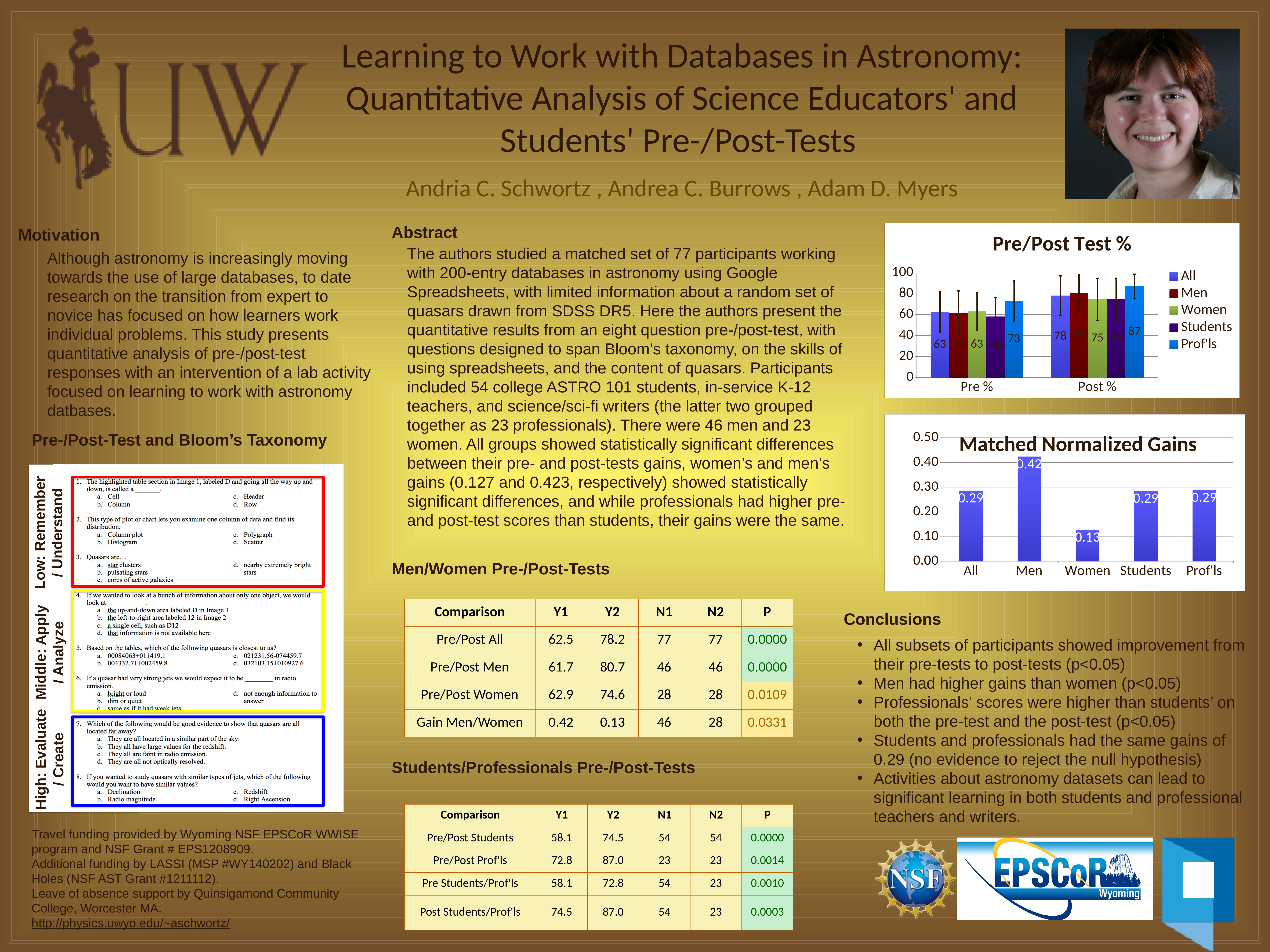
What kind of chart is the Matched Normalized Gains chart? Bar chart In the Pre/Post Test % chart, which series has the highest Post % value? Prof'ls In the Pre/Post Test % chart, what is the Pre % value for Prof'ls? 73 In the Matched Normalized Gains chart, which category has the lowest value? Women In the Pre/Post Test % chart, how many series does the legend list? 5 In the Pre/Post Test % chart, what is the Post % value for All? 78 In the Matched Normalized Gains chart, what is the difference between the values for Men and Women? 0.29 In the Pre/Post Test % chart, what is the Pre % value for Students? 58 In the Pre/Post Test % chart, is the Post % value for Men greater or less than 80? greater In the Pre/Post Test % chart, what is the difference between the Post % and Pre % values for Prof'ls? 14 In the Matched Normalized Gains chart, what is the value for Women? 0.13 In the Matched Normalized Gains chart, which category has the highest value? Men